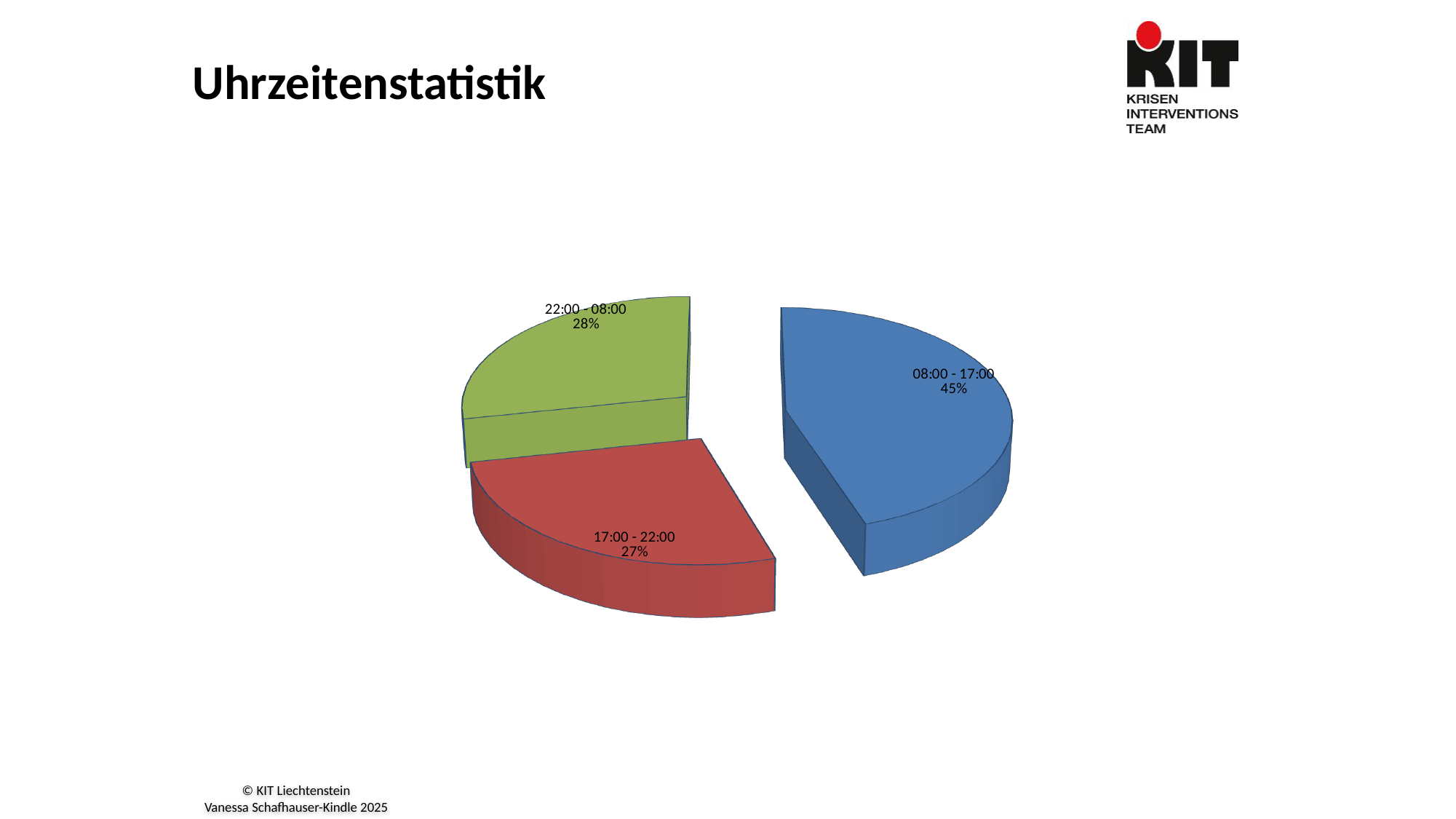
What is the title of the slide containing the pie chart? Uhrzeitenstatistik Which time period has the largest share of the pie? 08:00 - 17:00 What is the difference in percentage points between the 22:00 - 08:00 slice and the 17:00 - 22:00 slice? 1 Which is larger, the share for 08:00 - 17:00 or the share for 17:00 - 22:00? 08:00 - 17:00 What colour is the 08:00 - 17:00 slice of the pie chart? Blue What kind of chart is shown on the slide? Pie chart How many slices does the pie chart have? 3 What is the difference in percentage points between the 08:00 - 17:00 slice and the 22:00 - 08:00 slice? 17 Which time period has the smallest share of the pie? 17:00 - 22:00 What share of the pie does the 17:00 - 22:00 slice represent? 27% What share of the pie does the 08:00 - 17:00 slice represent? 45% What share of the pie does the 22:00 - 08:00 slice represent? 28%